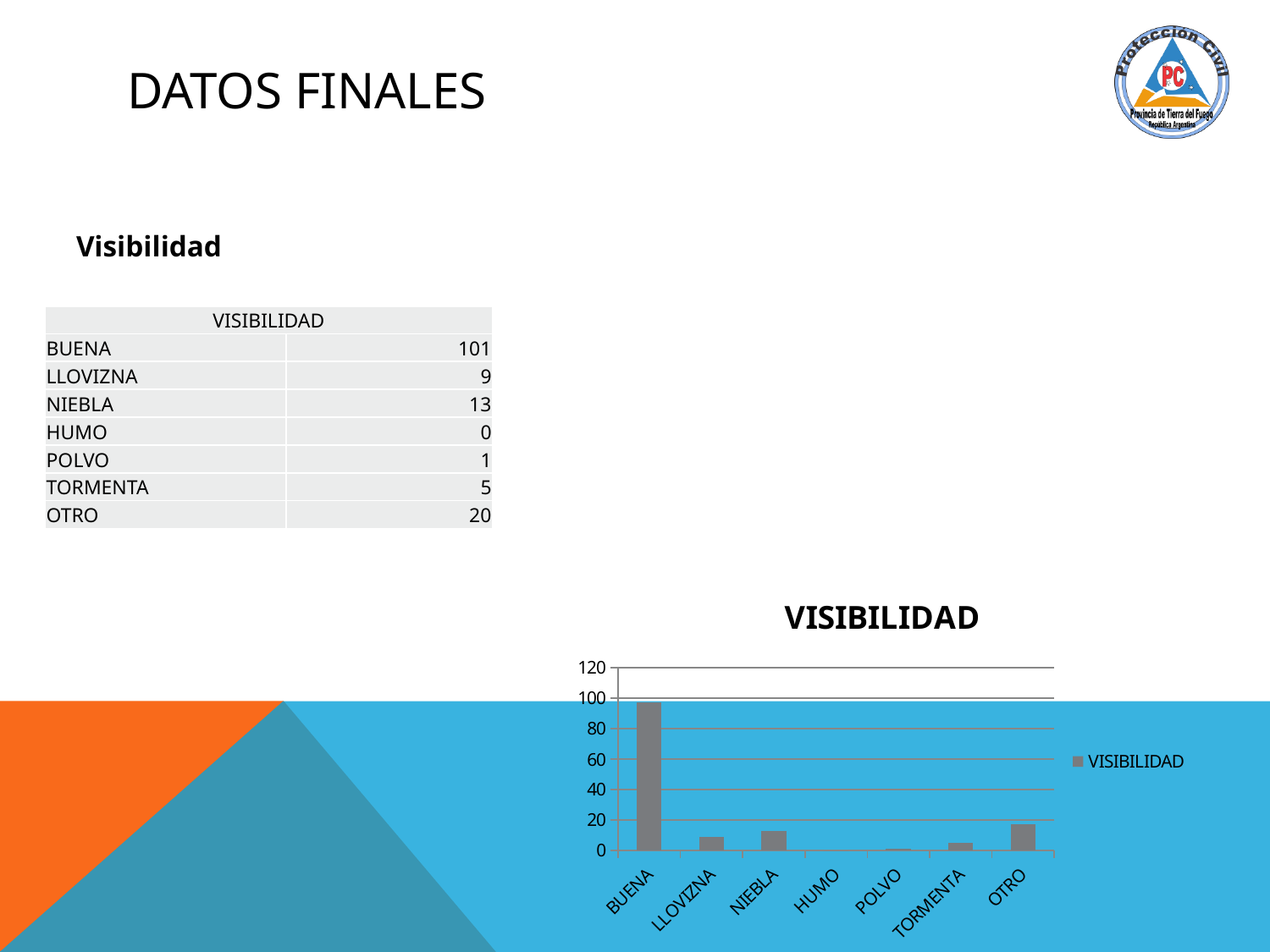
How many categories are shown on the x axis of the chart? 7 Which is larger, the value for NIEBLA or the value for LLOVIZNA? NIEBLA Which category has the lowest value in the chart? HUMO Which is larger, the value for OTRO or the value for TORMENTA? OTRO What is the title of the chart? VISIBILIDAD According to the slide, what is the difference between the values for NIEBLA and LLOVIZNA? 4 Is the value for OTRO greater or less than 40? less Is the value for BUENA greater or less than 80? greater How many series does the chart legend list? 1 What kind of chart is shown on the slide? bar chart Which category has the highest value in the chart? BUENA According to the slide, what is the value for NIEBLA? 13